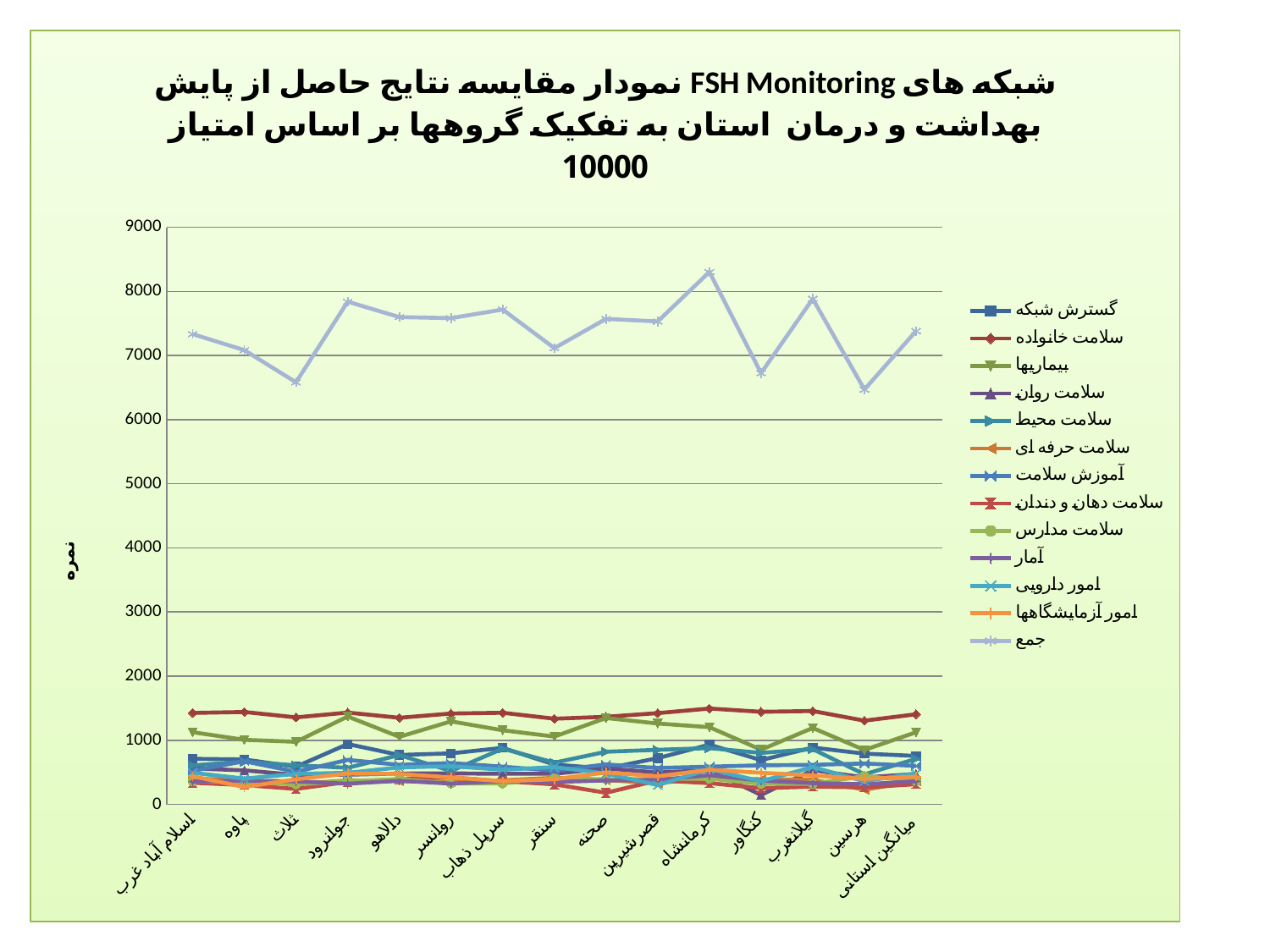
Is the value of جمع for میانگین استانی greater or less than 7000? greater How many categories are shown along the x axis? 15 For the جمع series, which category has the highest value? کرمانشاه Is the value of جمع for کرمانشاه greater or less than 8000? greater What is the label on the vertical axis? نمره Is the value of جمع for ثلاث greater or less than 7000? less What kind of chart is shown on the slide? line chart How many series does the legend list? 13 Which series has the highest values across all categories? جمع Which is larger: the جمع value for جوانرود or for پاوه? جوانرود